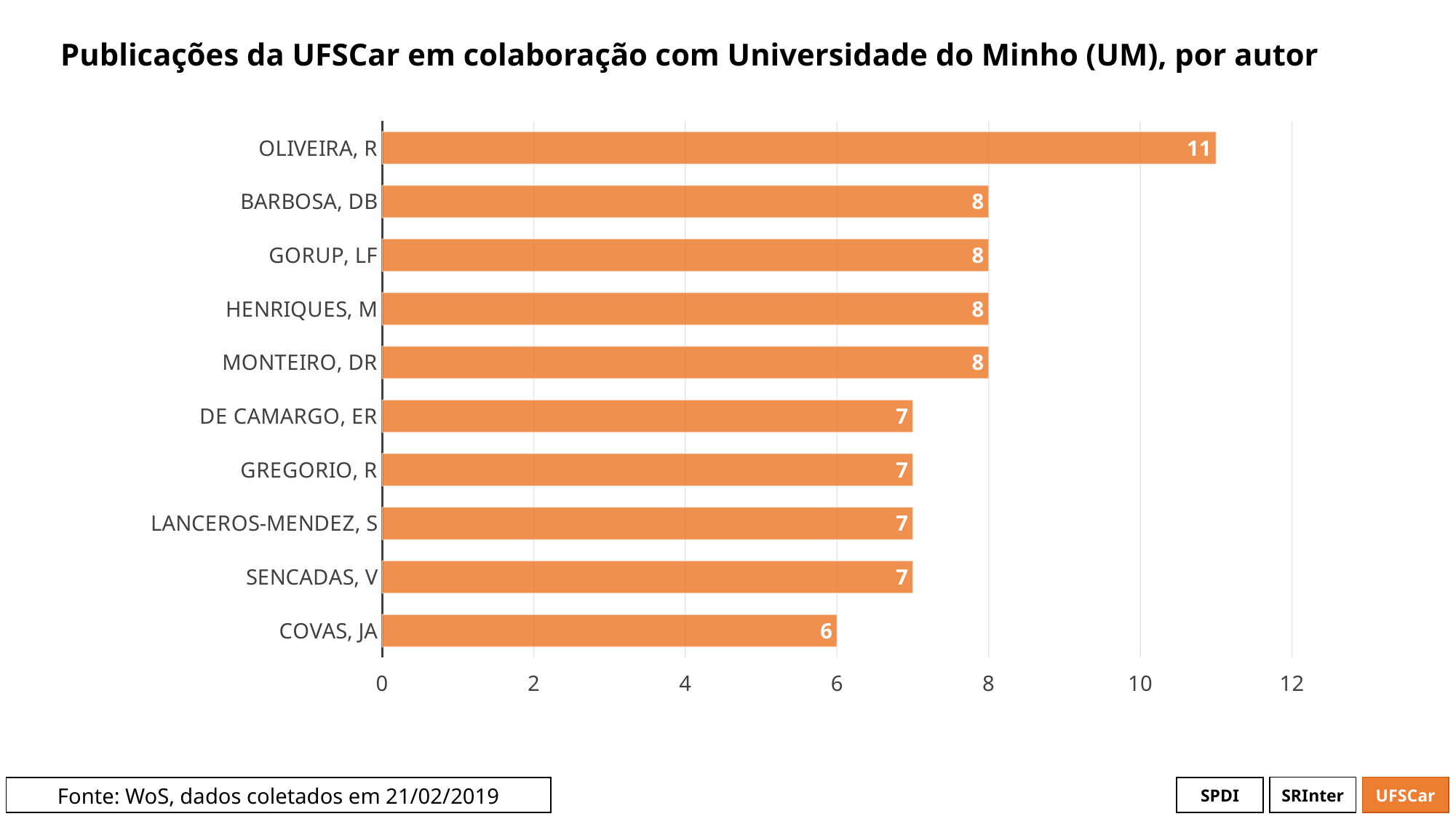
Which author has the highest number of publications? OLIVEIRA, R How many authors are shown in the chart? 10 Which is larger, the value for HENRIQUES, M or the value for SENCADAS, V? HENRIQUES, M What is the value for DE CAMARGO, ER? 7 How many publications does OLIVEIRA, R have? 11 What kind of chart is shown on the slide? bar chart Which author has the lowest number of publications? COVAS, JA What is the title of the chart? Publicações da UFSCar em colaboração com Universidade do Minho (UM), por autor What is the value for COVAS, JA? 6 What is the difference between the values for OLIVEIRA, R and BARBOSA, DB? 3 Is the value for OLIVEIRA, R greater or less than 10? greater What is the difference between the values for GORUP, LF and COVAS, JA? 2